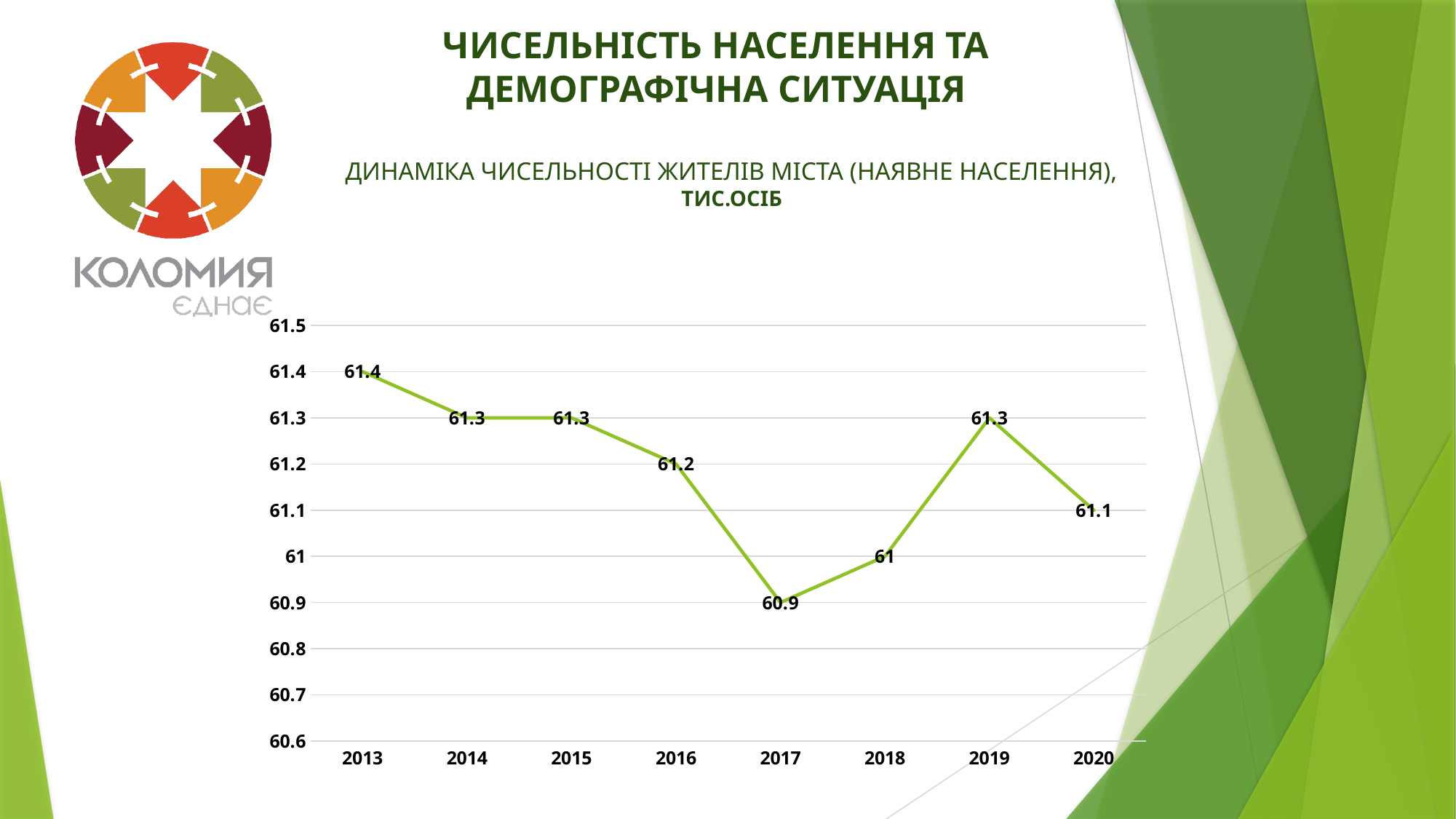
What is the value for 2020? 61.1 Which year has the lowest value? 2017 What is the value for 2013? 61.4 What is the difference between the values for 2013 and 2017? 0.5 What kind of chart is shown on the slide? Line chart How many years are plotted on the x axis? 8 What is the value for 2017? 60.9 What is the value for 2018? 61 What is the difference between the values for 2019 and 2020? 0.2 Does the value rise or fall from 2013 to 2017? Fall Which year has the highest value? 2013 Which is larger, the value for 2016 or the value for 2018? 2016